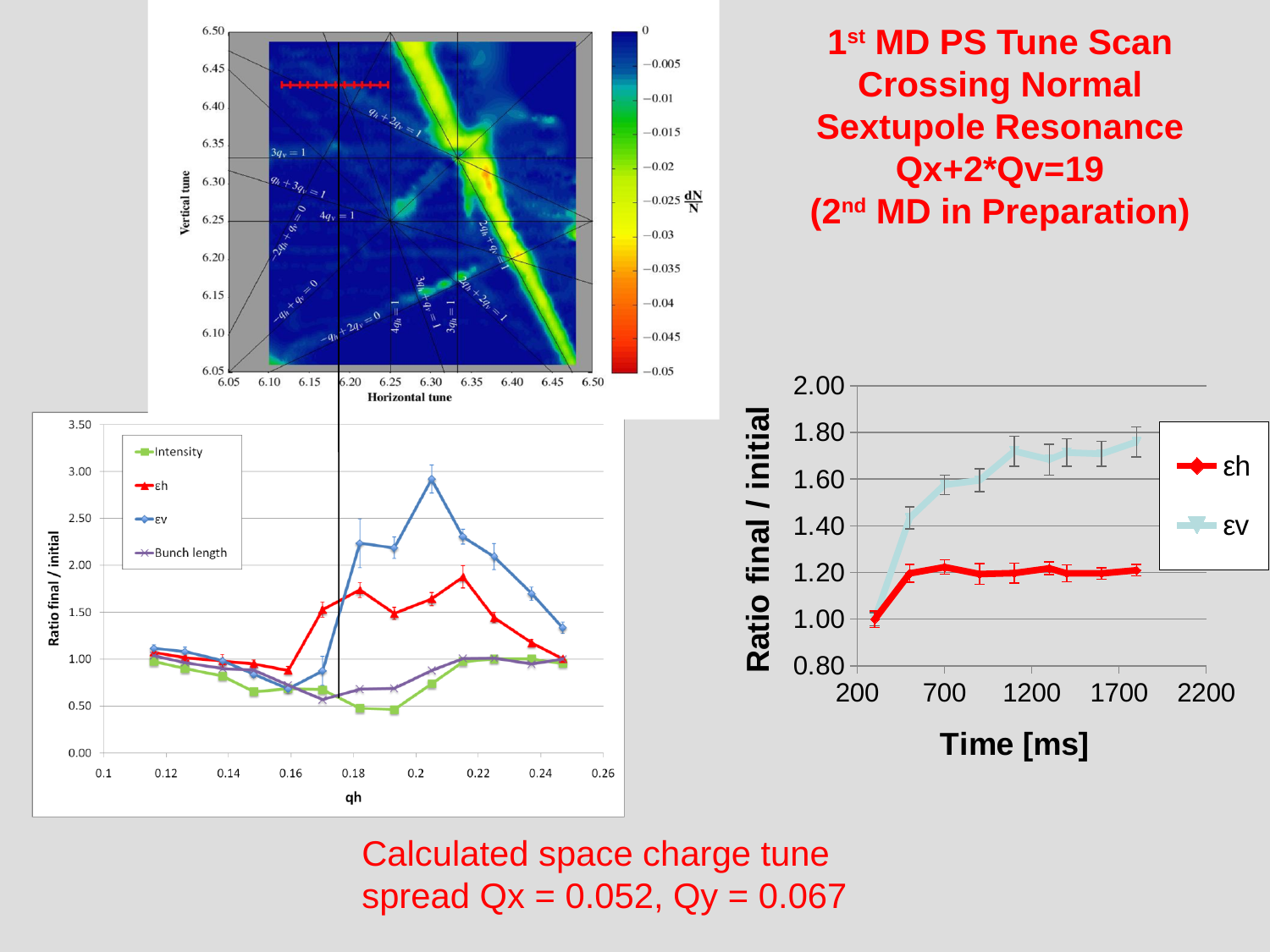
On the right-hand chart, what is the label of the x axis? Time [ms] On the bottom-left chart (Ratio final / initial vs qh), is the Intensity value at qh = 0.2 greater or less than 1.00? less On the right-hand chart (Ratio final / initial vs Time [ms]), which series is higher at 1700 ms, εh or εv? εv On the right-hand chart (Ratio final / initial vs Time [ms]), how many series does the legend list? 2 On the bottom-left chart (Ratio final / initial vs qh), is the peak value of the εv series greater or less than 2.50? greater On the bottom-left chart (Ratio final / initial vs qh), which series reaches the highest value? εv On the bottom-left chart (Ratio final / initial vs qh), how many series does the legend list? 4 On the right-hand chart (Ratio final / initial vs Time [ms]), is the εh value at 1700 ms greater or less than 1.40? less On the right-hand chart (Ratio final / initial vs Time [ms]), what kind of chart is it? line chart On the right-hand chart (Ratio final / initial vs Time [ms]), does the εv series rise or fall as time increases? rise On the bottom-left chart, what are the four legend entries? Intensity, εh, εv, Bunch length